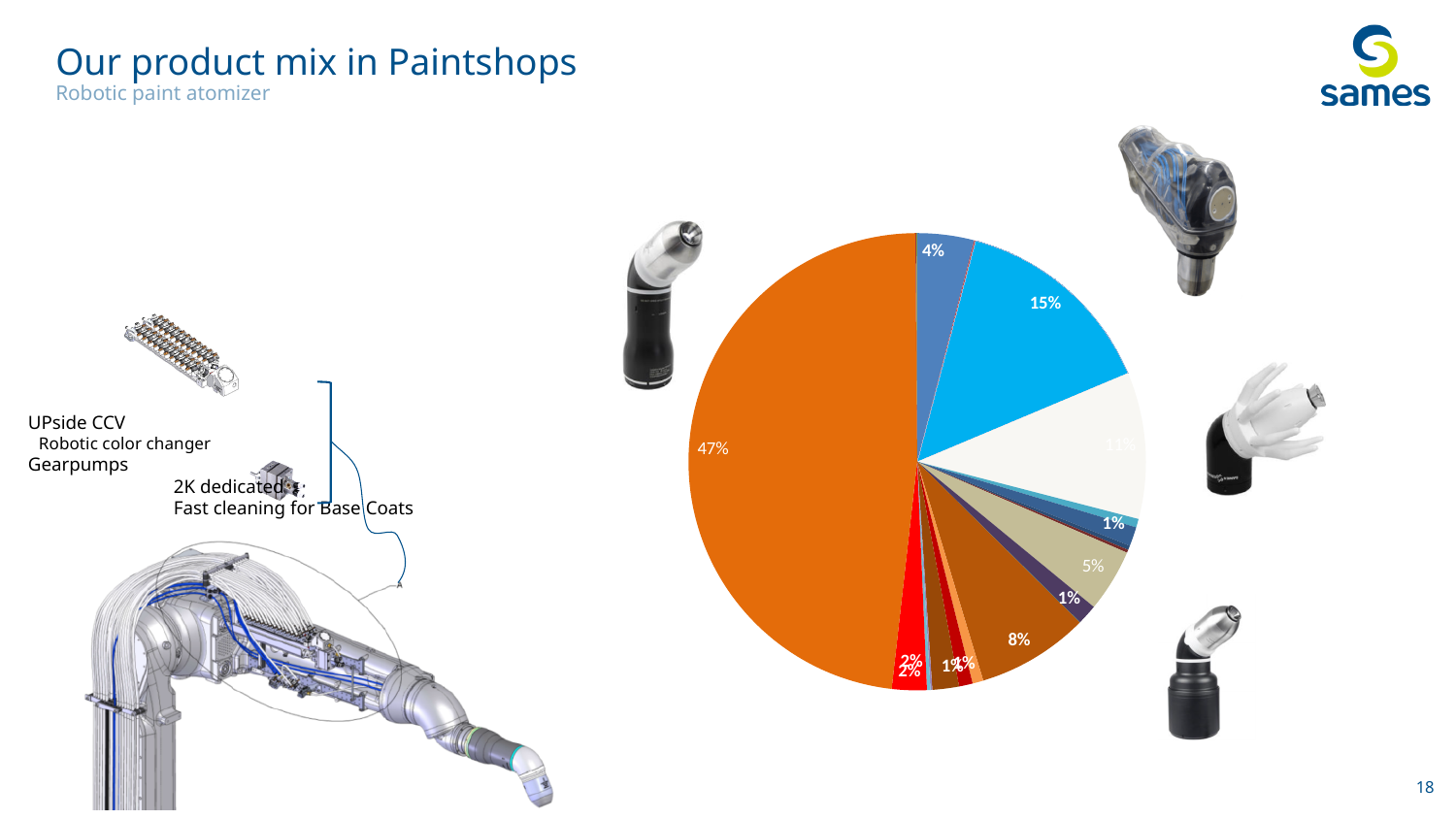
What percentage is labelled on the light blue slice at the top right of the pie chart? 15% What percentage is labelled on the brown slice at the bottom right of the pie chart? 8% What is the title of the slide containing the pie chart? Our product mix in Paintshops What percentage is labelled on the beige slice on the right side of the pie chart, below the 1% slice? 5% What kind of chart is shown on the slide? pie chart What share of the pie does the large orange slice represent? 47% By how many percentage points does the light blue slice (15%) exceed the brown slice (8%)? 7 percentage points What percentage is labelled on the dark blue slice at the top of the pie chart, just left of the light blue slice? 4% What percentage is shown on the largest slice of the pie chart? 47% By how many percentage points does the orange slice (47%) exceed the light blue slice (15%)? 32 percentage points Does the pie chart include a legend identifying the slices? No Which is larger in the pie chart: the orange slice or the light blue slice? the orange slice